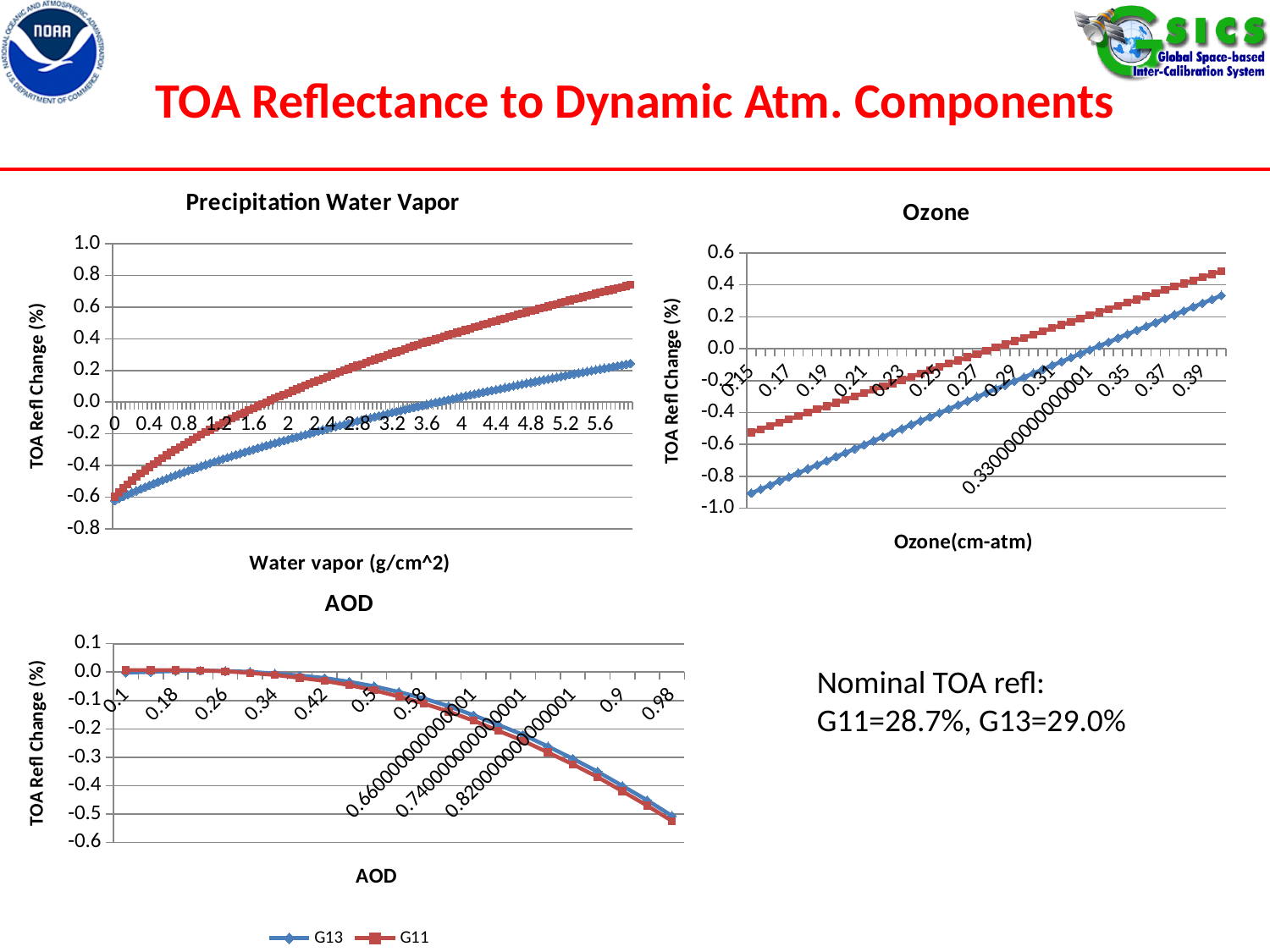
How many series does the legend at the bottom of the slide list? 2 What is the x-axis label of the Precipitation Water Vapor chart? Water vapor (g/cm^2) In the Ozone chart, do the values rise or fall as ozone increases? rise In the AOD chart, do the values rise or fall as AOD increases? fall In the Precipitation Water Vapor chart, which series has the higher TOA Refl Change at water vapor 4, G11 or G13? G11 In the Ozone chart, which series has the lower TOA Refl Change at ozone 0.15, G11 or G13? G13 In the Precipitation Water Vapor chart, is the value for G11 at the highest water vapor shown greater or less than 0.6? greater What kind of chart is the Precipitation Water Vapor chart? line chart In the Precipitation Water Vapor chart, is the value for G13 at the highest water vapor shown greater or less than 0.4? less In the Ozone chart, is the value for G13 at ozone 0.15 greater or less than -0.8? less In the Precipitation Water Vapor chart, do the values rise or fall as water vapor increases? rise What is the x-axis label of the Ozone chart? Ozone(cm-atm)